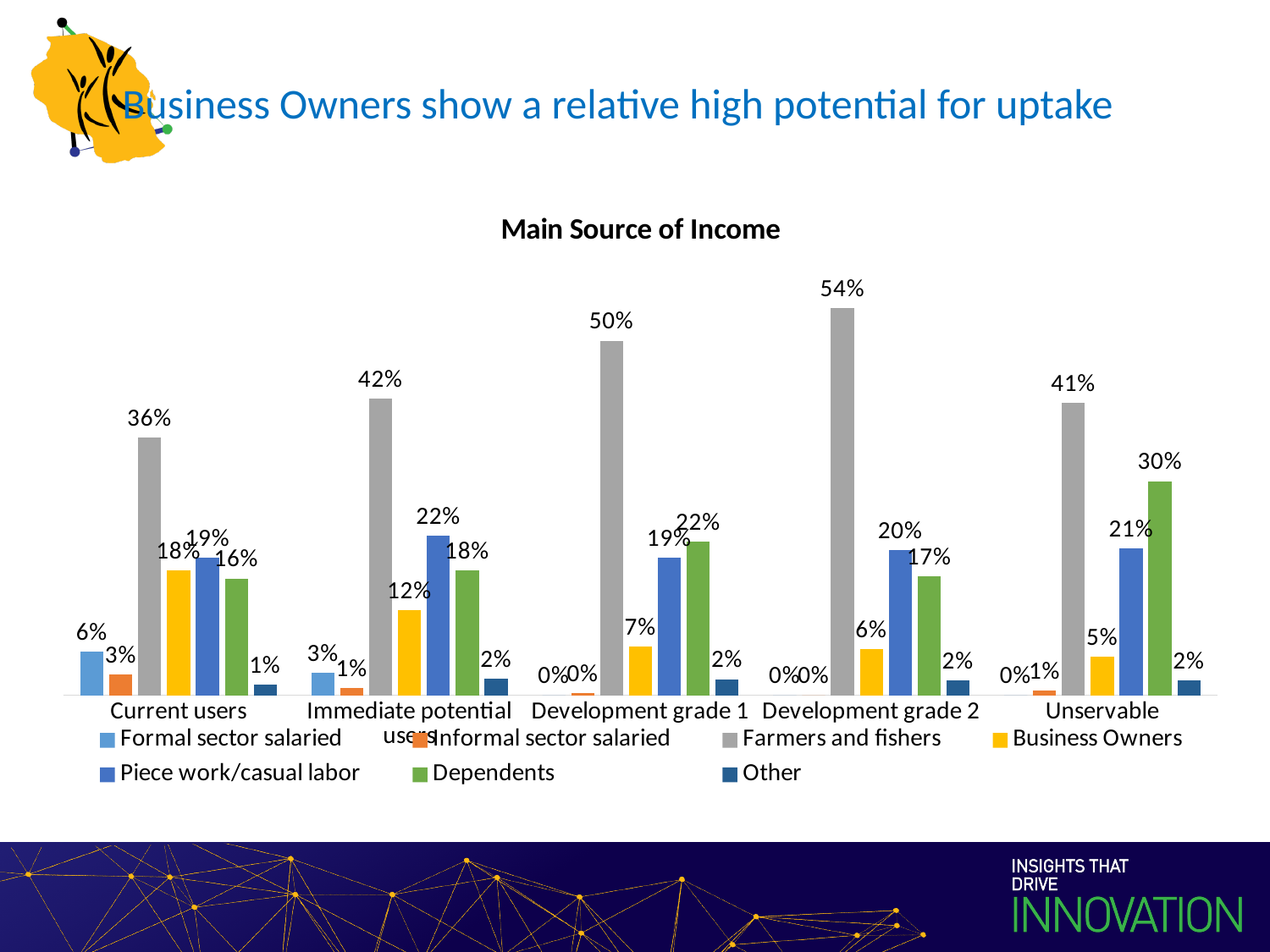
What is the difference between the Business Owners values for Current users and Development grade 1? 11% What is the value for Farmers and fishers in the Development grade 2 category? 54% What kind of chart is shown on the slide? Bar chart What is the value for Business Owners in the Current users category? 18% How many categories are shown on the x axis? 5 Which category has the lowest value for Business Owners? Unservable Which is larger: Piece work/casual labor for Immediate potential users or Dependents for Immediate potential users? Piece work/casual labor Do the Business Owners values rise or fall moving from Current users to Unservable along the x axis? Fall What is the value for Dependents in the Unservable category? 30% Which category has the highest value for Farmers and fishers? Development grade 2 What is the title of the chart? Main Source of Income How many series does the legend list? 7